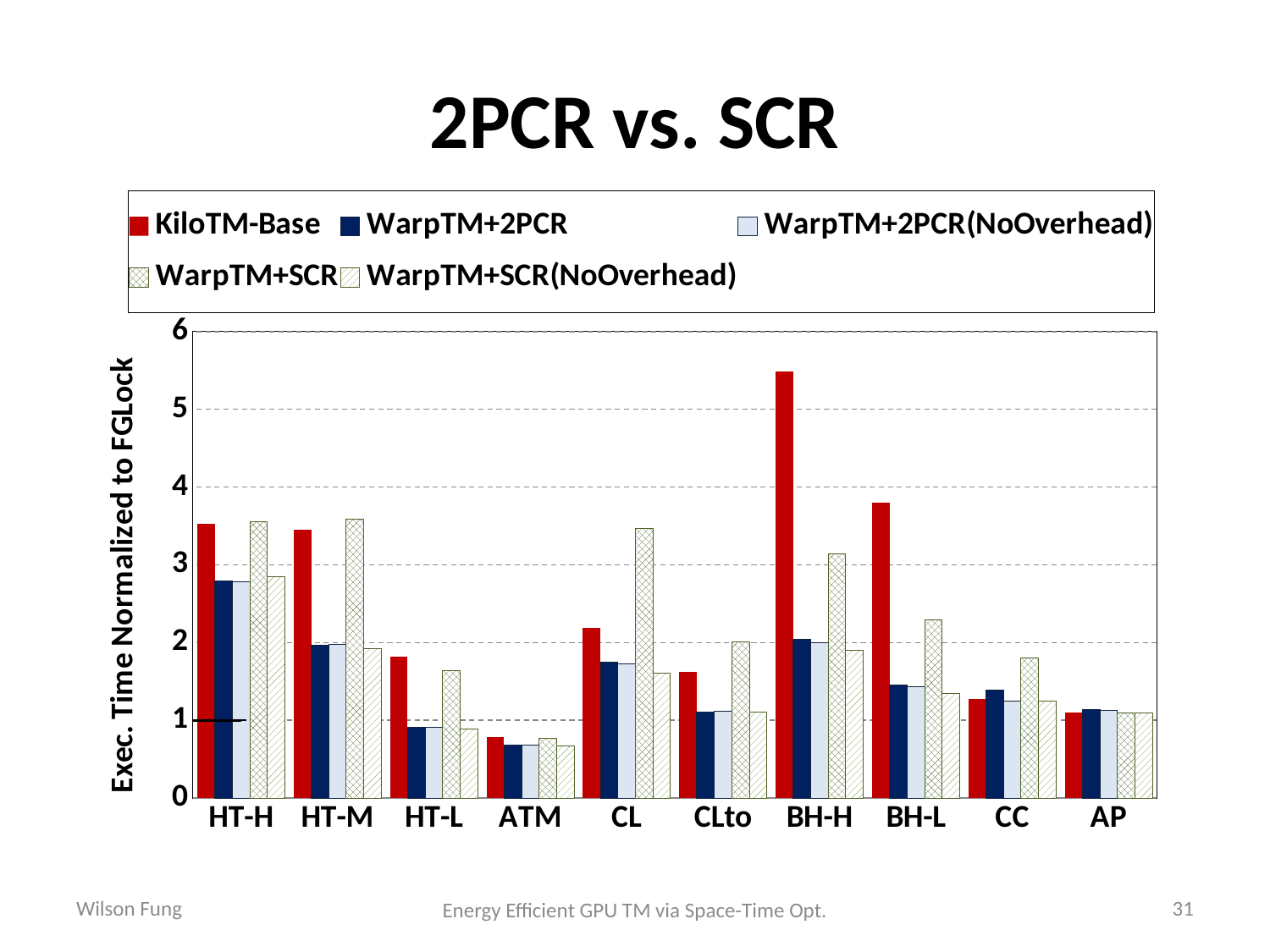
What is the title of the y axis? Exec. Time Normalized to FGLock Is the WarpTM+SCR value for CL greater or less than 3? greater For BH-H, which is larger: the KiloTM-Base value or the WarpTM+SCR value? KiloTM-Base Is the WarpTM+2PCR value for BH-L greater or less than 2? less Is the KiloTM-Base value for BH-H greater or less than 5? greater How many benchmark categories are shown along the x axis? 10 For HT-H, which is larger: the KiloTM-Base value or the WarpTM+2PCR value? KiloTM-Base What kind of chart is shown on the slide? bar chart For which benchmark is the KiloTM-Base bar the lowest? ATM For which benchmark is the KiloTM-Base bar the highest? BH-H How many series does the legend list? 5